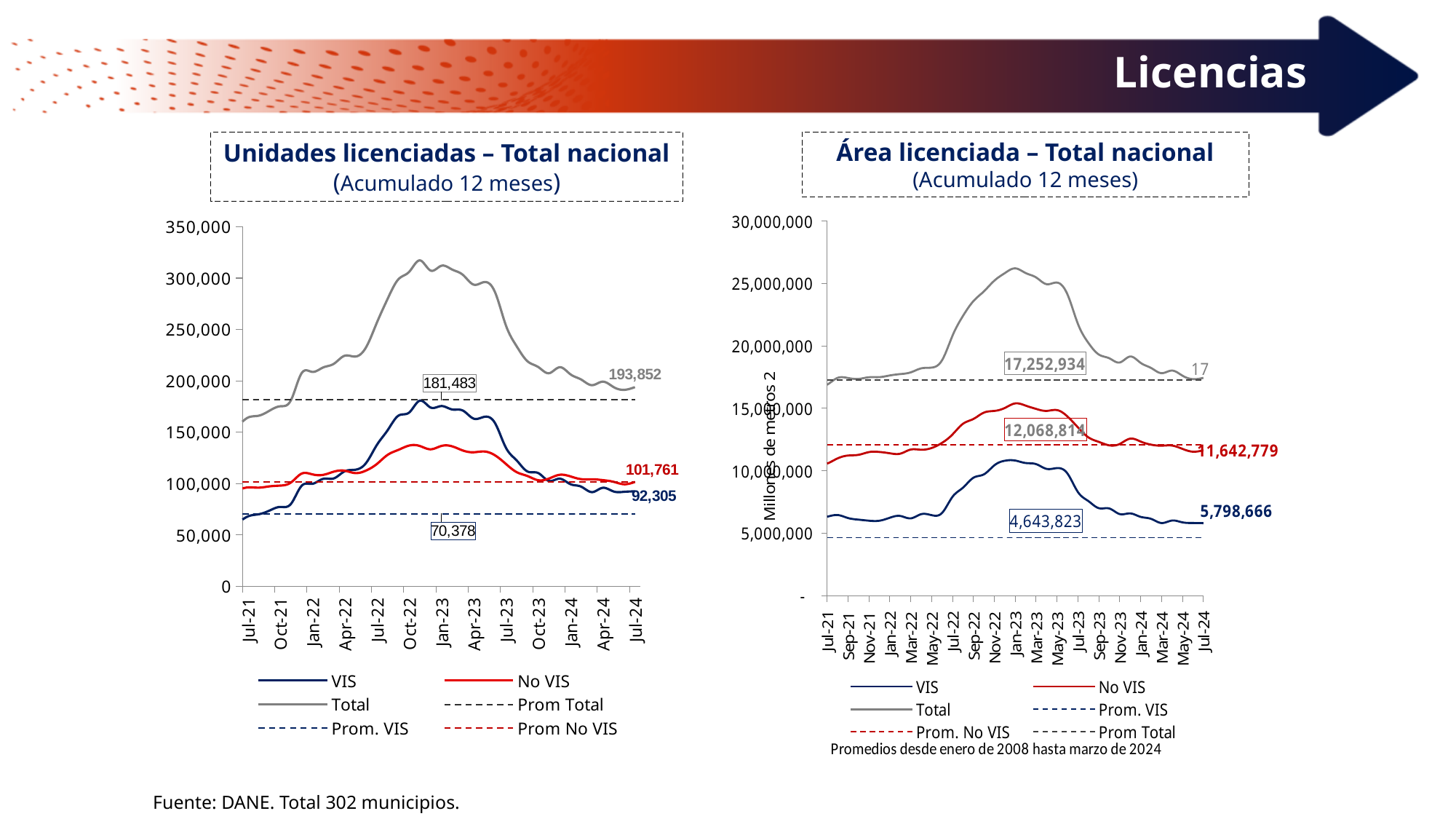
In the 'Unidades licenciadas – Total nacional' chart, what value is labelled on the Prom. VIS dashed line? 70,378 In the 'Unidades licenciadas – Total nacional' chart, what is the labelled value of the VIS series at Jul-24? 92,305 In the 'Área licenciada – Total nacional' chart, what value is labelled on the Prom. VIS dashed line? 4,643,823 In the 'Unidades licenciadas – Total nacional' chart, what value is labelled on the Prom Total dashed line? 181,483 In the 'Área licenciada – Total nacional' chart, what is the labelled value of the No VIS series at Jul-24? 11,642,779 In the 'Área licenciada – Total nacional' chart, what value is labelled on the Prom Total dashed line? 17,252,934 What kind of chart is the 'Unidades licenciadas – Total nacional' chart? Line chart In the 'Unidades licenciadas – Total nacional' chart, is the peak of the Total series greater or less than 300,000? greater In the 'Unidades licenciadas – Total nacional' chart, what is the difference between the labelled Jul-24 values of No VIS (101,761) and VIS (92,305)? 9,456 In the 'Área licenciada – Total nacional' chart, which series has the larger labelled value at Jul-24, VIS or No VIS? No VIS How many series does the legend of the 'Unidades licenciadas – Total nacional' chart list? 6 In the 'Unidades licenciadas – Total nacional' chart, what is the labelled value of the Total series at Jul-24? 193,852